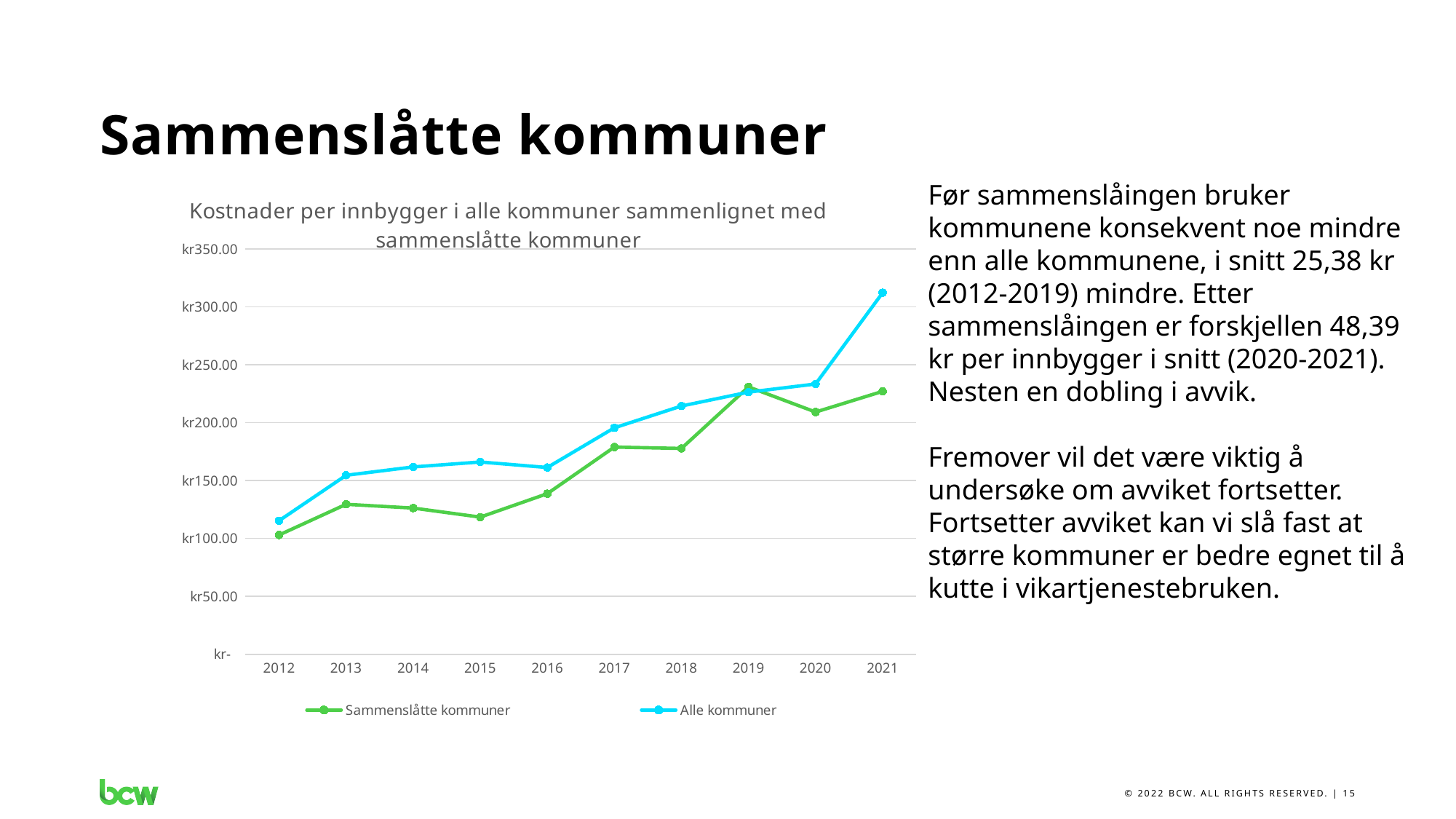
Overall, do the values for Alle kommuner rise or fall from 2012 to 2021? rise Which colour is used for the Sammenslåtte kommuner line? green Is the value for Sammenslåtte kommuner in 2012 greater or less than kr150.00? less How many series does the legend list? 2 Is the value for Alle kommuner in 2012 greater or less than kr150.00? less In 2021, which series has the larger value, Sammenslåtte kommuner or Alle kommuner? Alle kommuner Is the value for Alle kommuner in 2021 greater or less than kr300.00? greater How many years are plotted along the x axis? 10 Which year has the lowest value for Sammenslåtte kommuner? 2012 Which year has the highest value for Alle kommuner? 2021 What kind of chart is shown on the slide? line chart What is the title of the chart? Kostnader per innbygger i alle kommuner sammenlignet med sammenslåtte kommuner